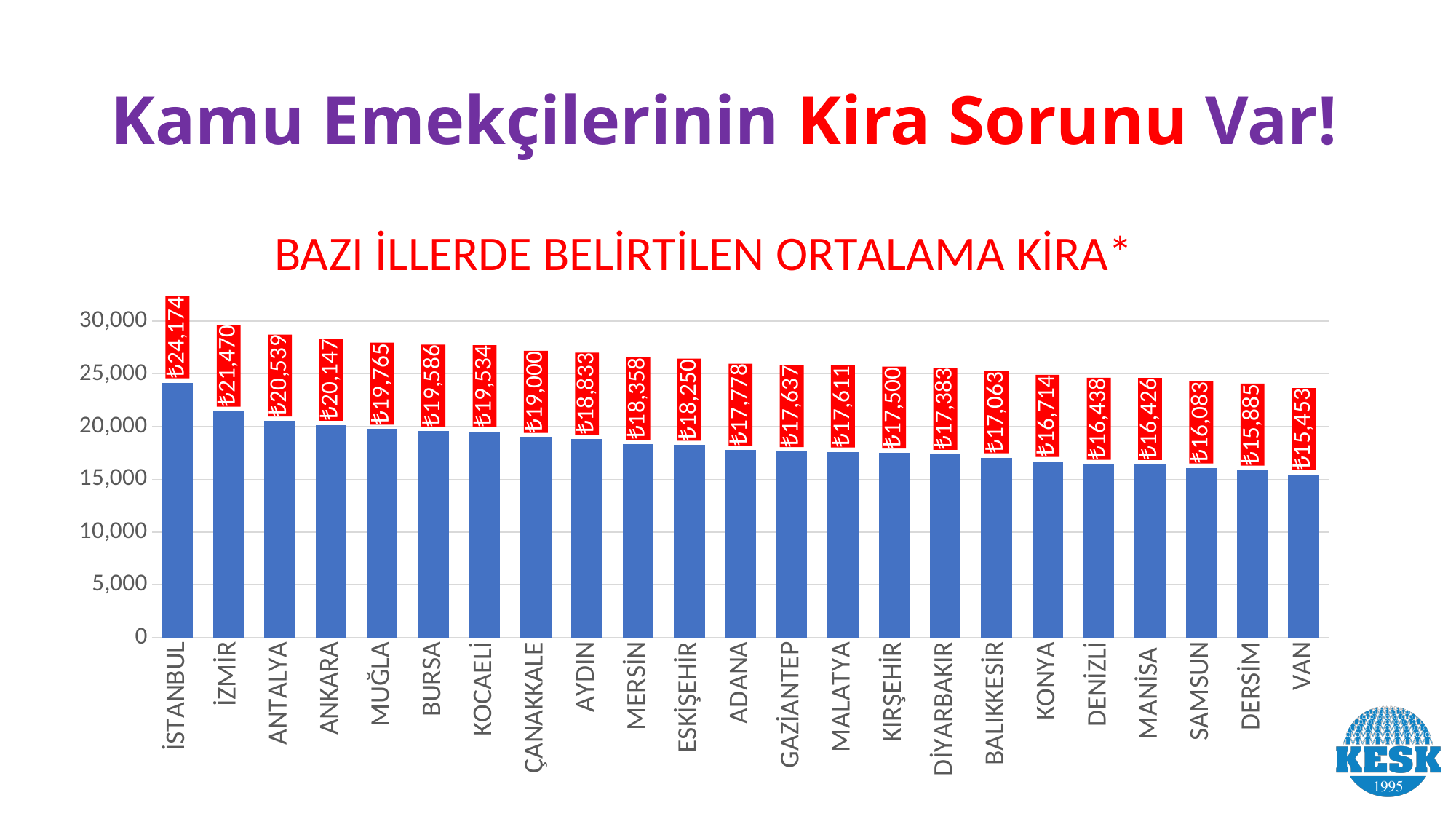
What kind of chart is shown on the slide? Bar chart What is the average rent shown for ANKARA? ₺20,147 What is the average rent shown for DİYARBAKIR? ₺17,383 What is the average rent shown for VAN? ₺15,453 Do the values rise or fall from left to right along the x axis? Fall Which province has the highest average rent in the chart? İSTANBUL What is the difference between the average rent for İSTANBUL and VAN? ₺8,721 What is the difference between the average rent for İSTANBUL and İZMİR? ₺2,704 Which province has the lowest average rent in the chart? VAN What is the average rent shown for İSTANBUL? ₺24,174 How many provinces are shown in the chart? 23 Which has a higher average rent, ANTALYA or KONYA? ANTALYA